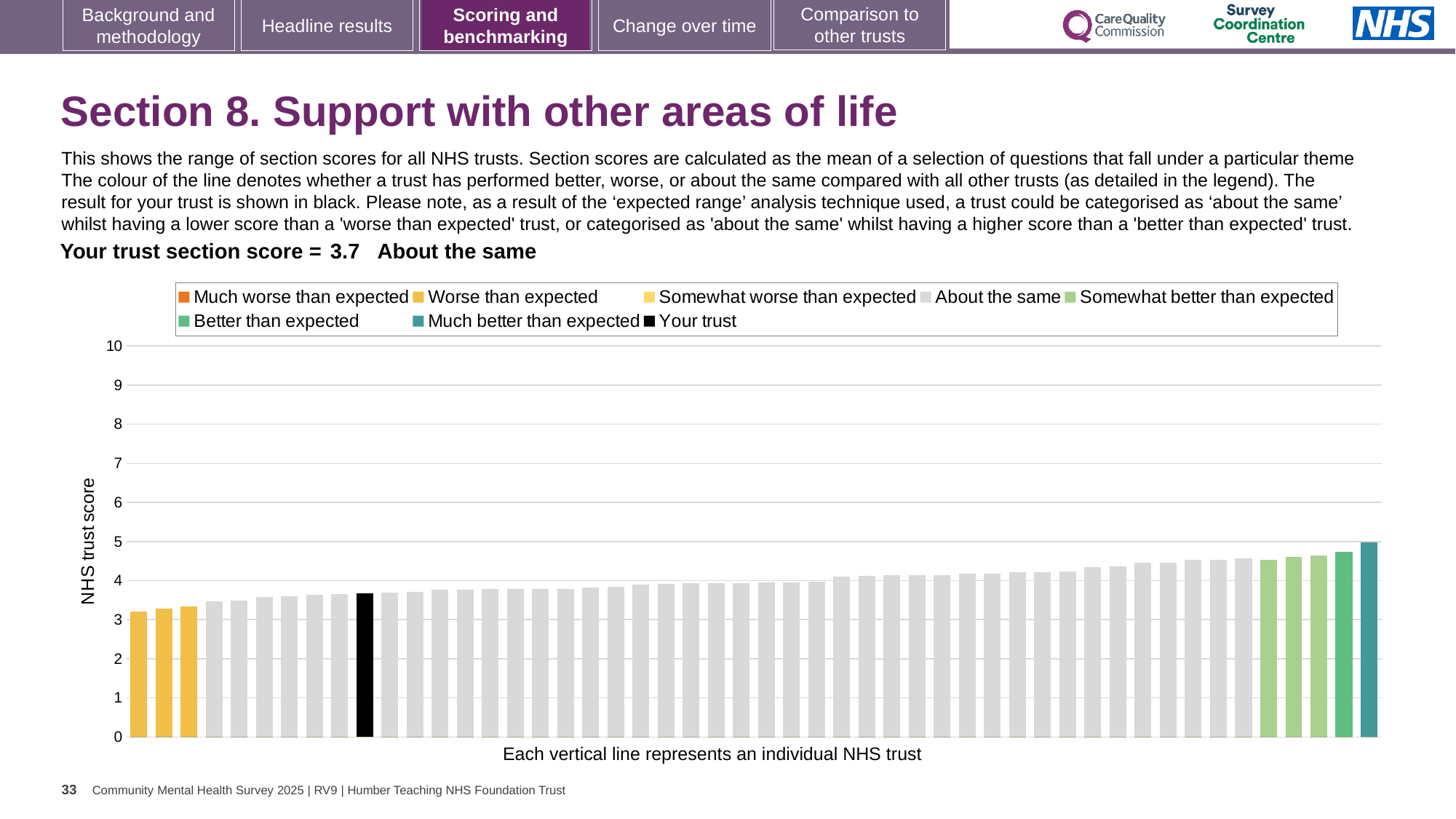
What colour is used for the 'Your trust' bar in the chart? black Which category is your trust placed in according to the slide? About the same Is the value of the black 'Your trust' bar greater or less than 4? less How many bars are coloured as 'Much better than expected' (teal)? 1 What is the label on the vertical axis of the chart? NHS trust score What is the section score for your trust shown on the slide? 3.7 Is the value of the leftmost (lowest) bar greater or less than 3? greater What kind of chart is shown on the slide? bar chart Is the value of the leftmost bar greater or less than 4? less How many bars are coloured as 'Worse than expected' (yellow)? 3 Do the bar values rise or fall from left to right along the x axis? rise How many entries does the chart legend list? 8